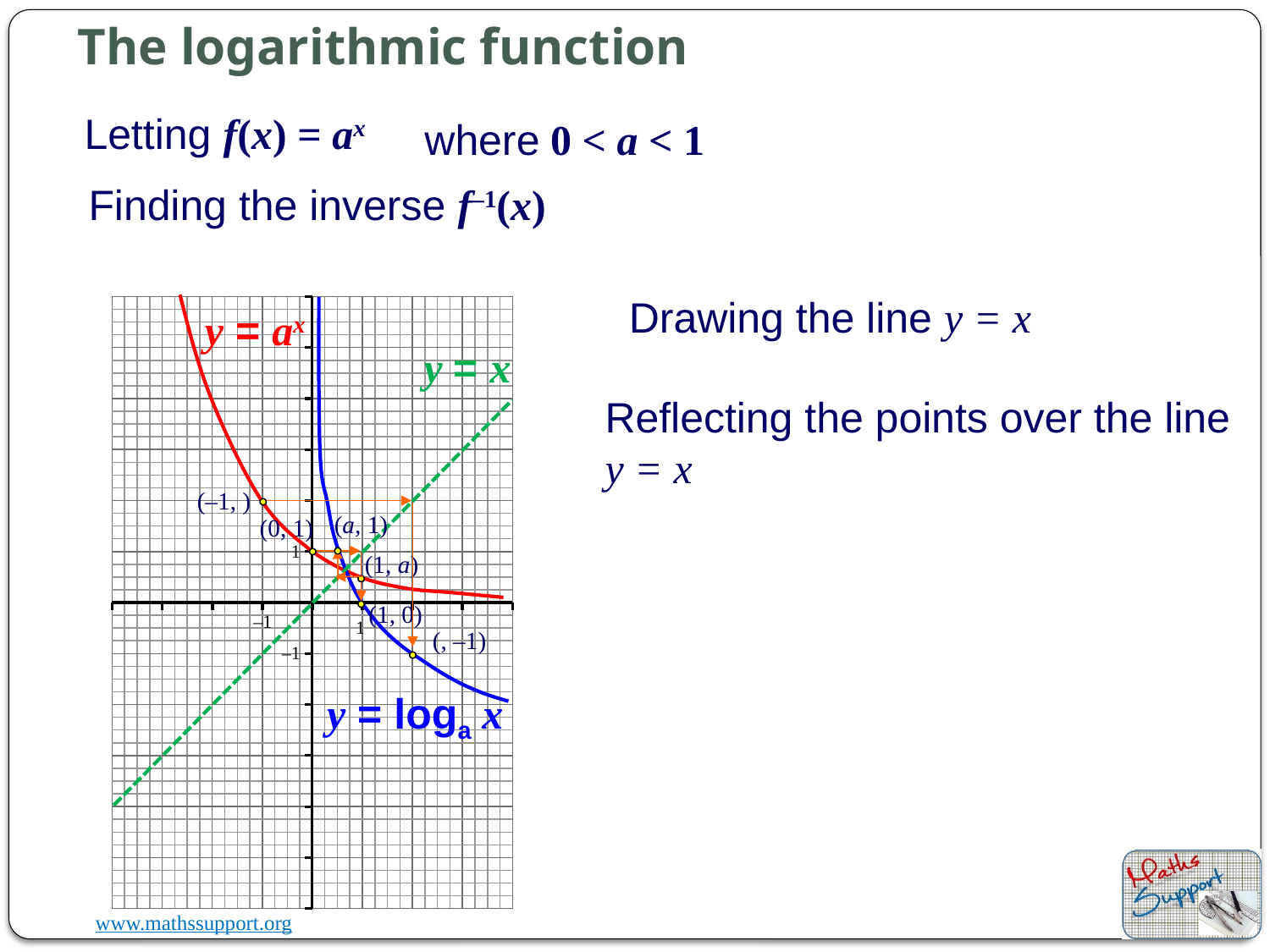
What are the coordinates of the labelled point where the red curve crosses the y-axis? (0, 1) What type of chart is shown on the slide? line chart Which labelled point on the blue curve is the reflection of (1, a) over the line y = x? (a, 1) What are the coordinates of the labelled point where the blue curve crosses the x-axis? (1, 0) What is the equation labelled on the red curve? y = a^x Does the red curve y = a^x rise or fall as x increases? fall Is the line y = x drawn as a solid or dashed line? dashed Does the blue curve y = log_a x rise or fall as x increases? fall What is the equation labelled on the green dashed line? y = x What colour is the line y = x drawn in? green How many curves or lines are plotted on the graph? 3 What is the equation labelled on the blue curve? y = log_a x